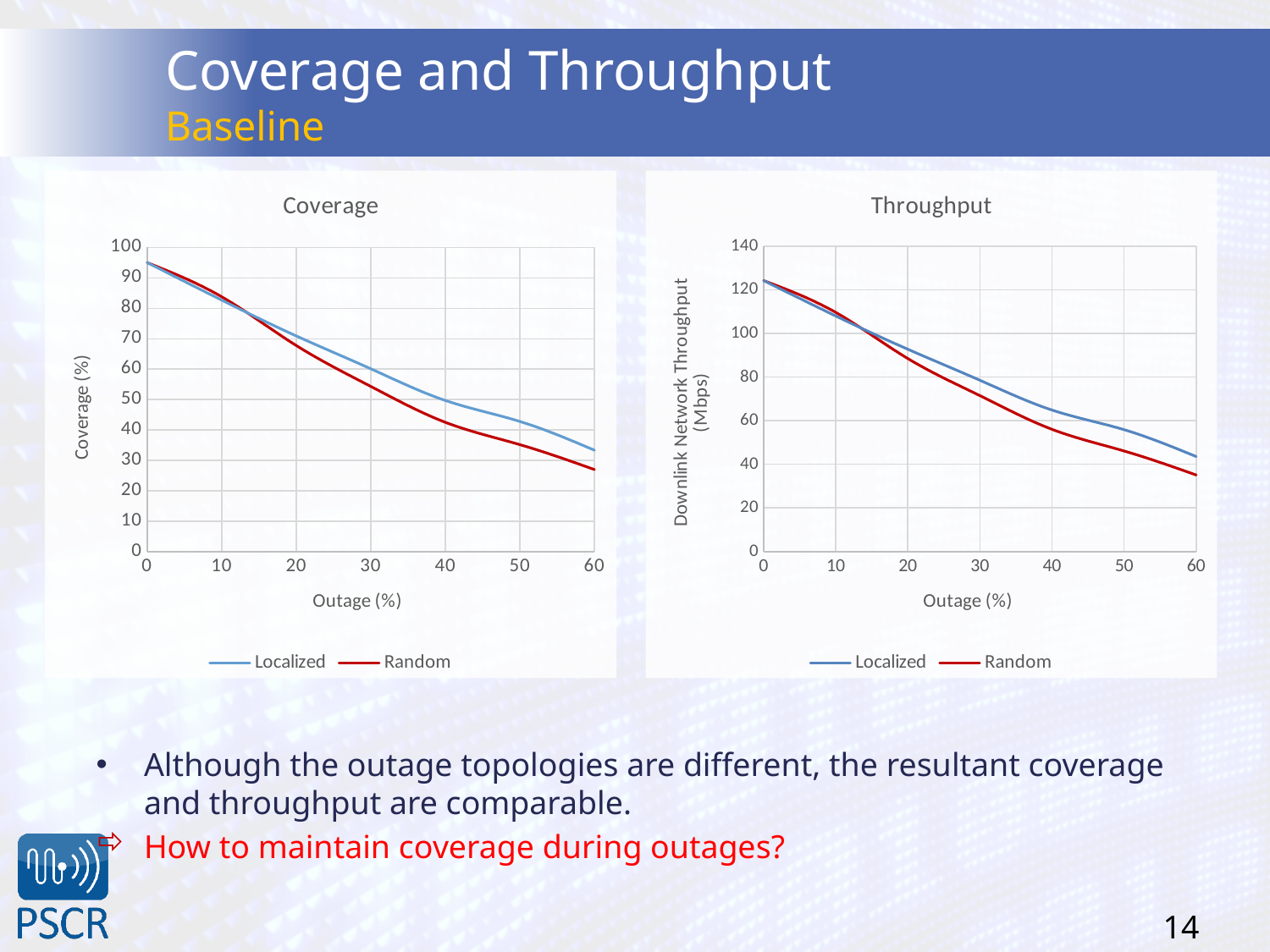
In the Throughput chart, is the Random value at 40% outage greater or less than 60? less In the Throughput chart, is the Localized value at 40% outage greater or less than 60? greater In the Coverage chart, is the Random value at 30% outage greater or less than 60? less What kind of chart is the Coverage chart? line chart In the Throughput chart, at 40% outage, which series has the higher value, Localized or Random? Localized How many series does the legend of the Throughput chart list? 2 In the Coverage chart, at 60% outage, which series has the higher value, Localized or Random? Localized In the Coverage chart, does coverage rise or fall as outage increases along the x axis? fall In the Throughput chart, does downlink network throughput rise or fall as outage increases? fall What is the y-axis label of the Throughput chart? Downlink Network Throughput (Mbps)